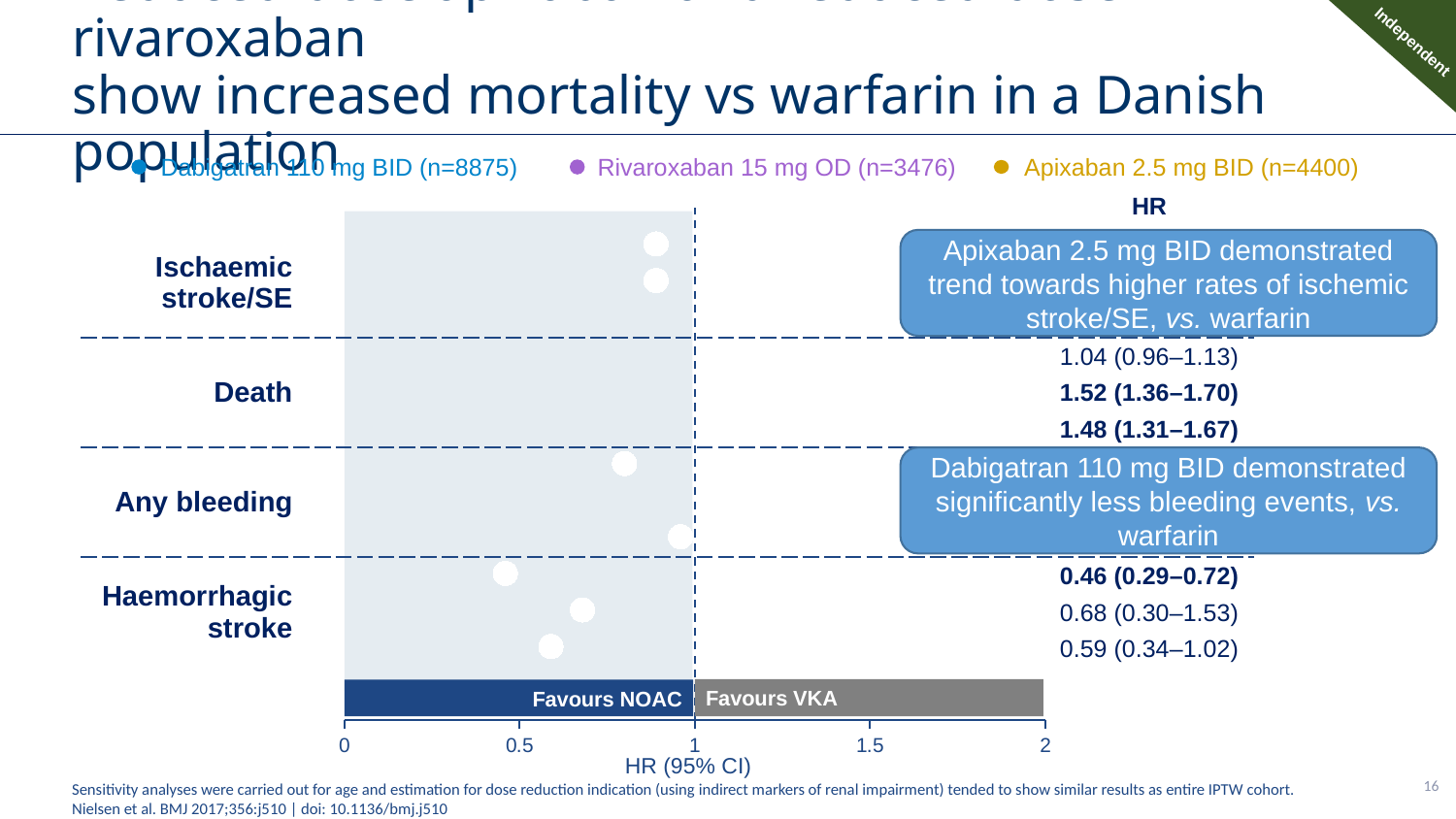
Are the HR points for Death greater or less than 1? greater What is the first HR (95% CI) listed for Death? 1.04 (0.96–1.13) What is the highest HR point estimate listed for Death? 1.52 How many outcome categories are listed on the y axis of the chart? 4 Which outcome has the larger highest HR point estimate, Death or Haemorrhagic stroke? Death What sample size (n) does the legend give for Rivaroxaban 15 mg OD? 3476 What is the difference between the highest and lowest HR point estimates listed for Death? 0.48 What kind of chart is shown on the slide? forest plot (dot plot of hazard ratios) What is the lowest HR (95% CI) listed for Haemorrhagic stroke? 0.46 (0.29–0.72) Are the HR points for Haemorrhagic stroke greater or less than 1? less How many series does the legend list? 3 What is the label of the x axis? HR (95% CI)